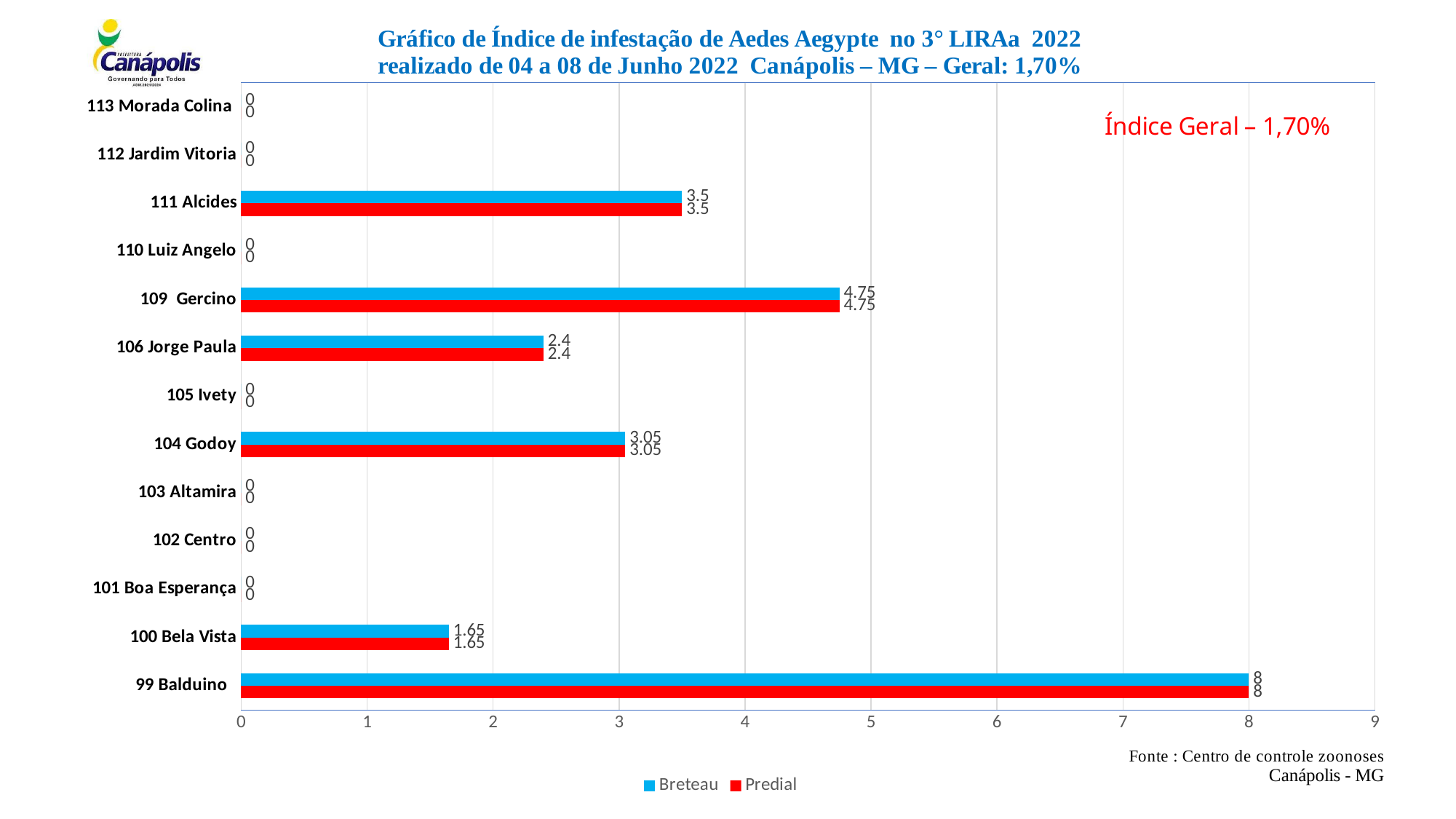
What is the Breteau value for 100 Bela Vista? 1.65 Is the Breteau value for 109 Gercino greater or less than 4? greater What is the Predial value for 104 Godoy? 3.05 What kind of chart is shown? bar chart Which colour represents the Predial series? red What is the Breteau value for 109 Gercino? 4.75 How many series does the legend list? 2 How many categories are shown on the y axis? 13 Which is larger, the Predial value for 106 Jorge Paula or for 104 Godoy? 104 Godoy Which category has the highest Breteau value? 99 Balduino What is the difference between the Breteau values for 99 Balduino and 111 Alcides? 4.5 How many categories have a Breteau value of 0? 7